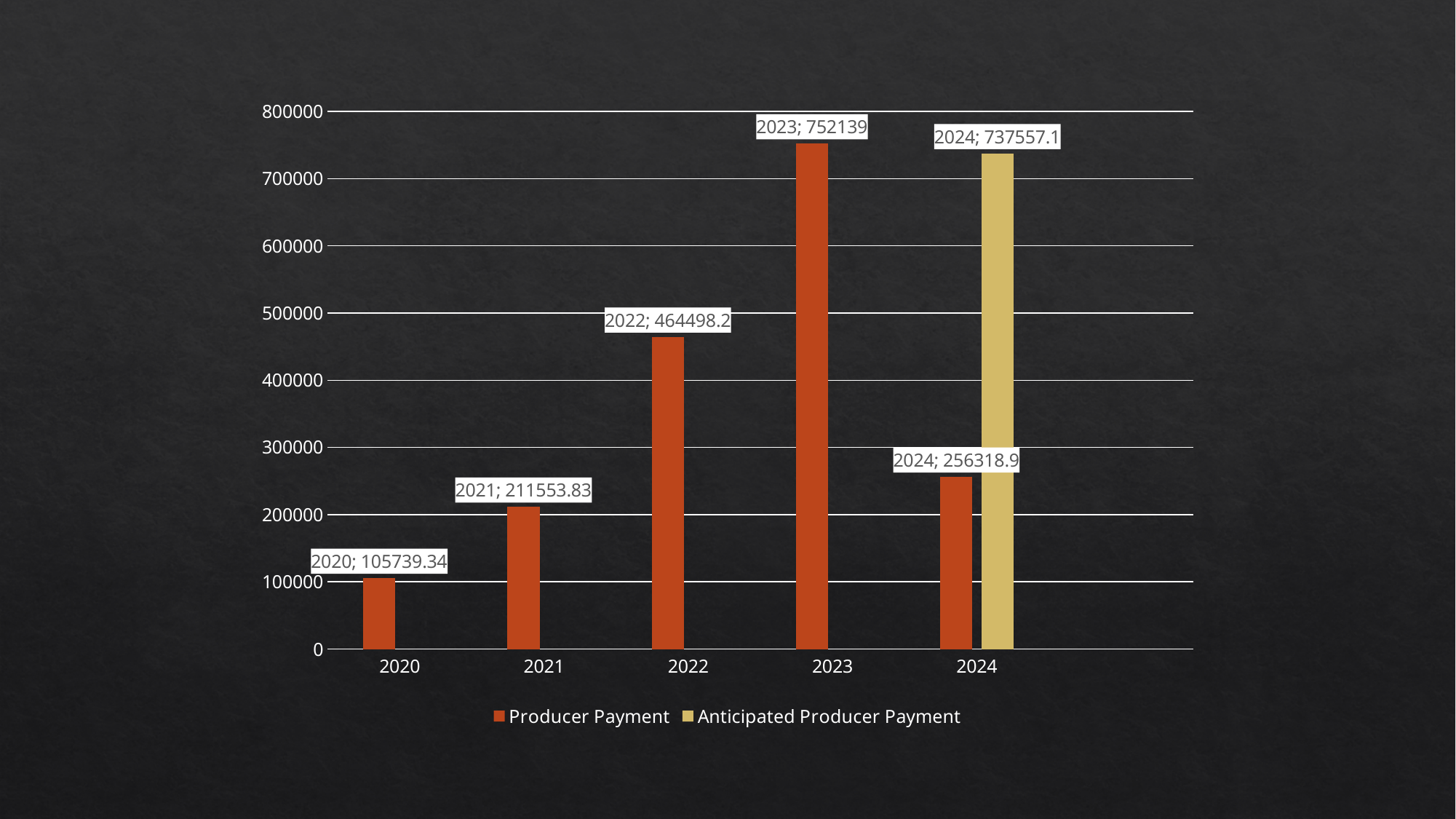
Which is larger: the Producer Payment for 2021 or for 2024? 2024 What is the difference between the Producer Payment in 2023 and in 2022? 287640.8 How many years are shown on the x axis? 5 How many series does the legend list? 2 What is the Producer Payment value for 2020? 105739.34 What is the Anticipated Producer Payment value for 2024? 737557.1 What kind of chart is shown on the slide? bar chart What is the Producer Payment value for 2022? 464498.2 Is the Producer Payment for 2023 greater or less than 700000? greater Which year has the highest Producer Payment? 2023 Which year has the lowest Producer Payment? 2020 What is the difference between the Anticipated Producer Payment and the Producer Payment for 2024? 481238.2